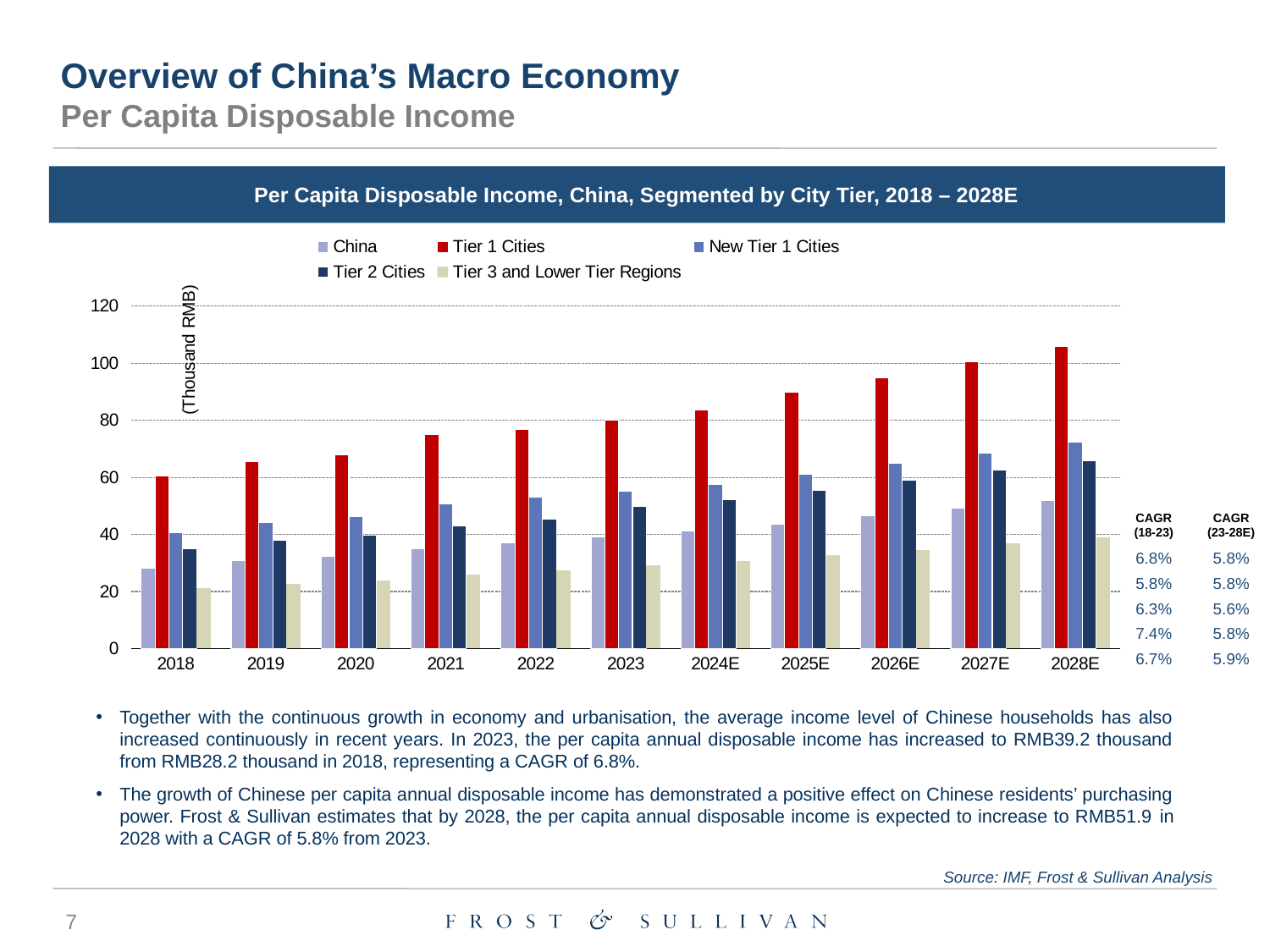
How many series does the legend list? 5 What is the title of the chart? Per Capita Disposable Income, China, Segmented by City Tier, 2018 – 2028E Is the value for New Tier 1 Cities in 2028E greater or less than 60? greater Is the value for China in 2018 greater or less than 40? less How many years are shown along the x axis? 11 Which series has the lowest value in 2018? Tier 3 and Lower Tier Regions Do the values for Tier 1 Cities rise or fall from 2018 to 2028E? rise Is the value for Tier 1 Cities in 2026E greater or less than 100? less What kind of chart is shown on the slide? bar chart Which is larger in 2023: Tier 1 Cities or Tier 2 Cities? Tier 1 Cities Which series has the highest value in 2028E? Tier 1 Cities